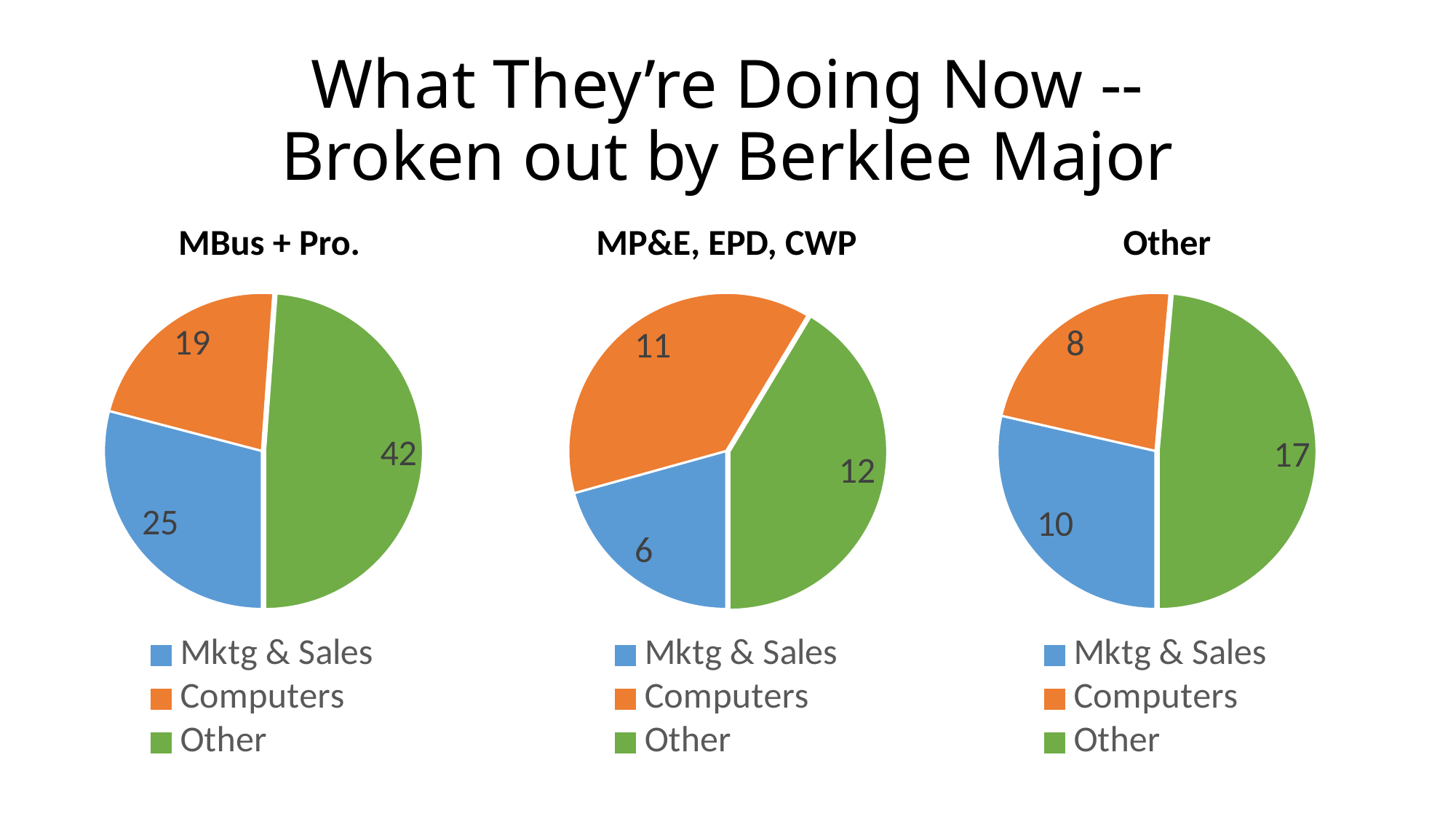
In the MBus + Pro. chart, which category has the smallest slice? Computers In the Other chart, which category has the smallest slice? Computers In the MP&E, EPD, CWP chart, what is the value for Computers? 11 In the Other chart, what is the value for Mktg & Sales? 10 What kind of chart is the MBus + Pro. chart? Pie chart In the MP&E, EPD, CWP chart, which is larger, Computers or Mktg & Sales? Computers In the MP&E, EPD, CWP chart, which category has the largest slice? Other How many slices does the MP&E, EPD, CWP chart have? 3 In the Other chart, what is the total of all slices? 35 In the MBus + Pro. chart, what is the value for Other? 42 In the MBus + Pro. chart, what is the difference between Other and Mktg & Sales? 17 How many entries does the legend of the Other chart list? 3